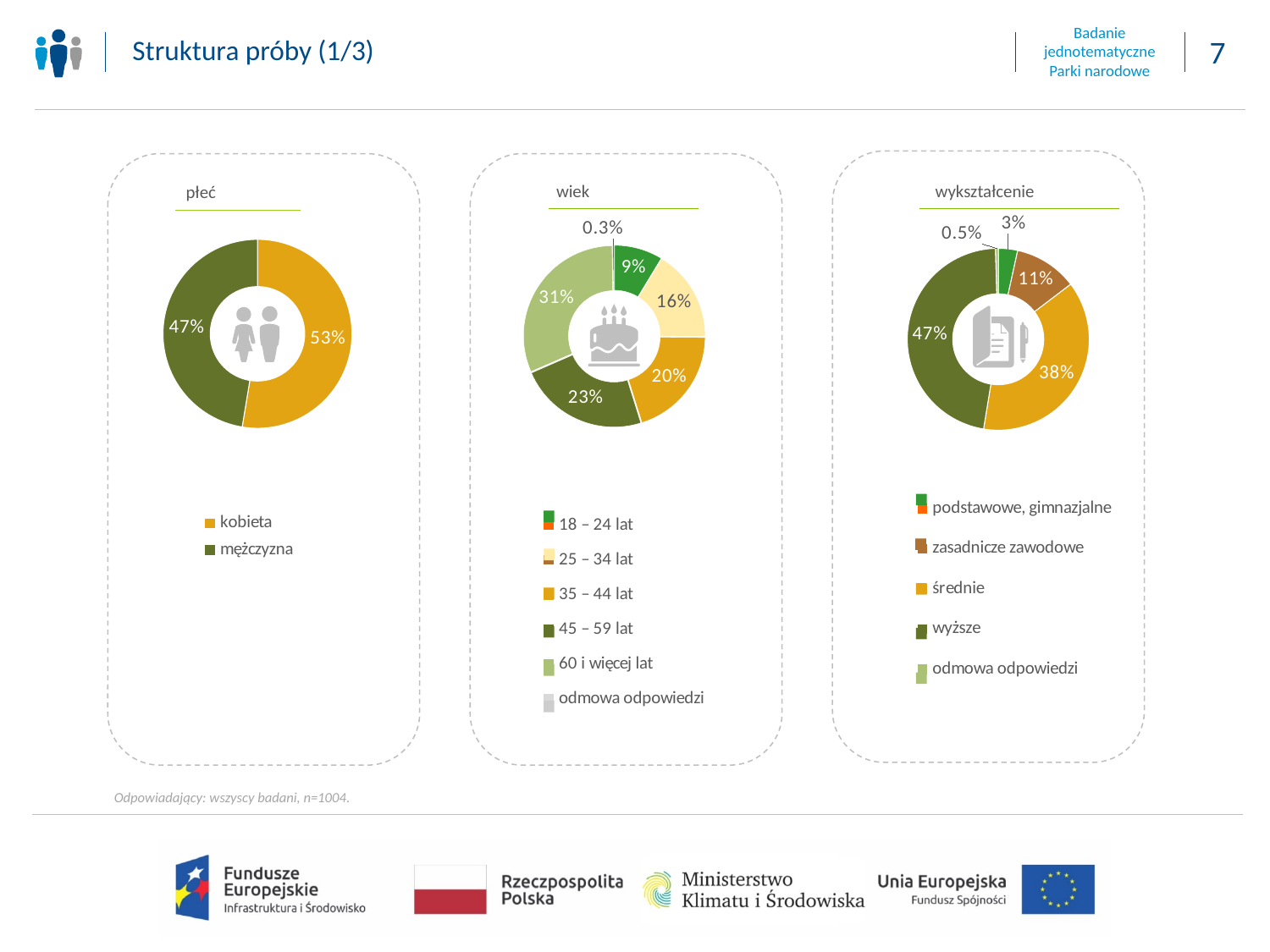
In the 'wiek' chart, what share is shown for 35 – 44 lat? 20% In the 'płeć' chart, which category has the larger share, kobieta or mężczyzna? kobieta In the 'wykształcenie' chart, what is the difference between the średnie and podstawowe, gimnazjalne shares? 35% In the 'wykształcenie' chart, what share is shown for zasadnicze zawodowe? 11% In the 'wiek' chart, what share is shown for 60 i więcej lat? 31% In the 'wiek' chart, how many categories does the legend list? 6 In the 'płeć' chart, what share is labelled for kobieta? 53% What type of chart is used for the 'płeć' data? pie (donut) chart In the 'płeć' chart, what is the difference between the kobieta and mężczyzna shares? 6% In the 'wiek' chart, which category has the smallest share? odmowa odpowiedzi In the 'wykształcenie' chart, which category has the largest share? wyższe In the 'wykształcenie' chart, what share is shown for wyższe? 47%